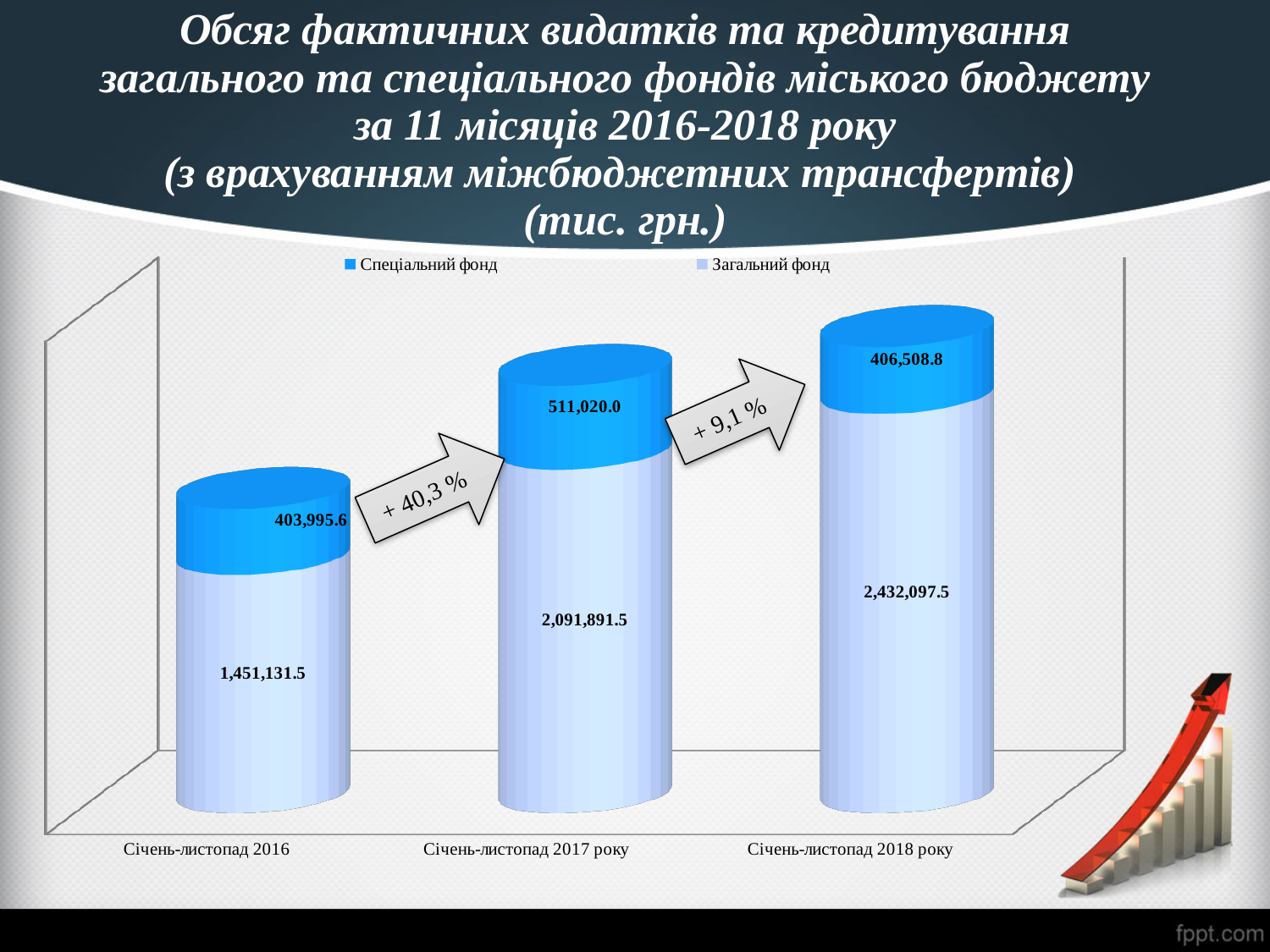
What is the total of the stacked bar for Січень-листопад 2016? 1,855,127.1 What kind of chart is shown on the slide? Stacked bar chart Which period has the highest value for Спеціальний фонд? Січень-листопад 2017 року How many series does the legend list? 2 What is the difference between the Загальний фонд values for Січень-листопад 2018 року and Січень-листопад 2017 року? 340,206.0 What is the value of Загальний фонд for Січень-листопад 2017 року? 2,091,891.5 Which is larger: Спеціальний фонд for Січень-листопад 2018 року or for Січень-листопад 2016? Січень-листопад 2018 року Does the Загальний фонд value rise or fall from Січень-листопад 2016 to Січень-листопад 2018 року? Rise What is the value of Спеціальний фонд for Січень-листопад 2016? 403,995.6 What is the value of Загальний фонд for Січень-листопад 2018 року? 2,432,097.5 How many periods (categories) are shown on the x axis? 3 Which period has the lowest value for Загальний фонд? Січень-листопад 2016